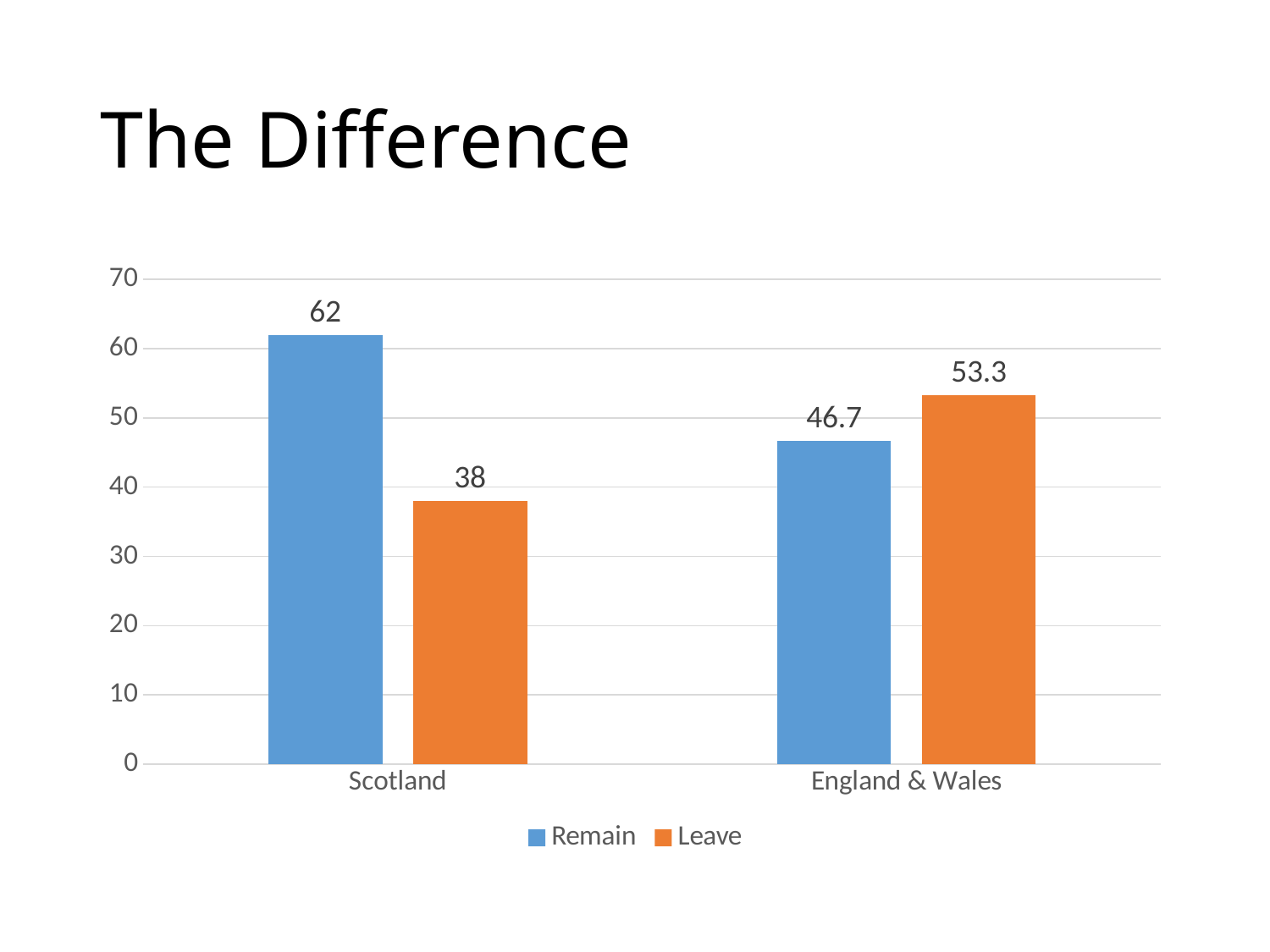
What is the Remain value for England & Wales? 46.7 Which category has the highest Remain value? Scotland What is the Leave value for England & Wales? 53.3 What is the Leave value for Scotland? 38 How many series does the legend list? 2 What is the difference between the Leave and Remain values for England & Wales? 6.6 Which category has the lowest Leave value? Scotland How many categories are shown on the x axis? 2 Which is larger for England & Wales, Remain or Leave? Leave What is the difference between the Remain and Leave values for Scotland? 24 What is the Remain value for Scotland? 62 What kind of chart is shown on the slide? Bar chart